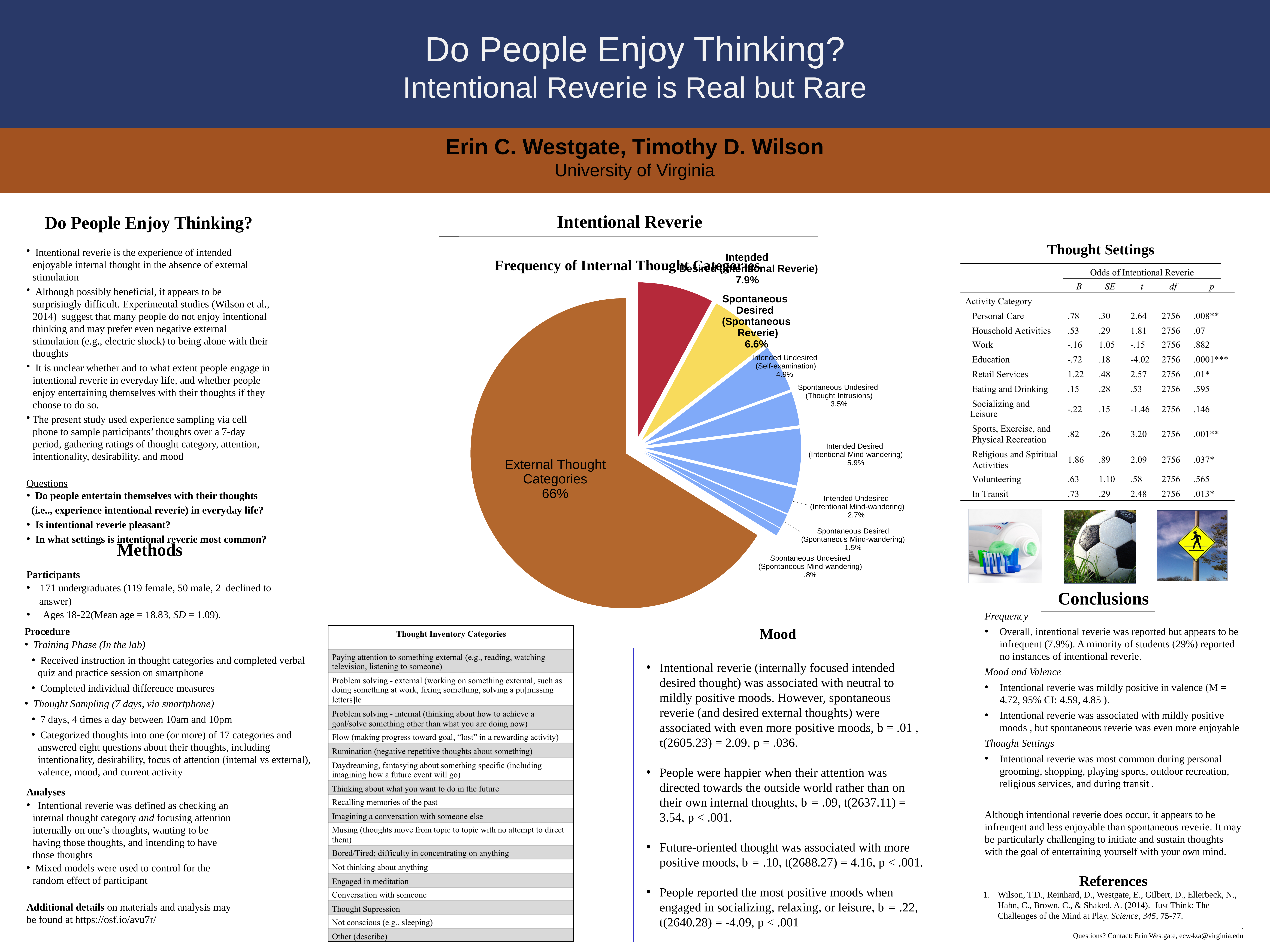
What share of the pie is External Thought Categories? 66% What percentage is shown for Spontaneous Desired (Spontaneous Reverie)? 6.6% Which slice of the pie chart is the largest? External Thought Categories How many slices does the pie chart have? 9 What percentage is shown for Intended Desired (Intentional Reverie)? 7.9% Which slice of the pie chart is the smallest? Spontaneous Undesired (Spontaneous Mind-wandering) What is the title of the pie chart? Frequency of Internal Thought Categories What percentage is shown for Spontaneous Undesired (Thought Intrusions)? 3.5% What is the difference in percentage points between Intended Desired (Intentional Reverie) and Spontaneous Desired (Spontaneous Reverie)? 1.3% What percentage is shown for Intended Desired (Intentional Mind-wandering)? 5.9% What kind of chart is shown on the slide? pie chart What percentage is shown for Intended Undesired (Self-examination)? 4.9%